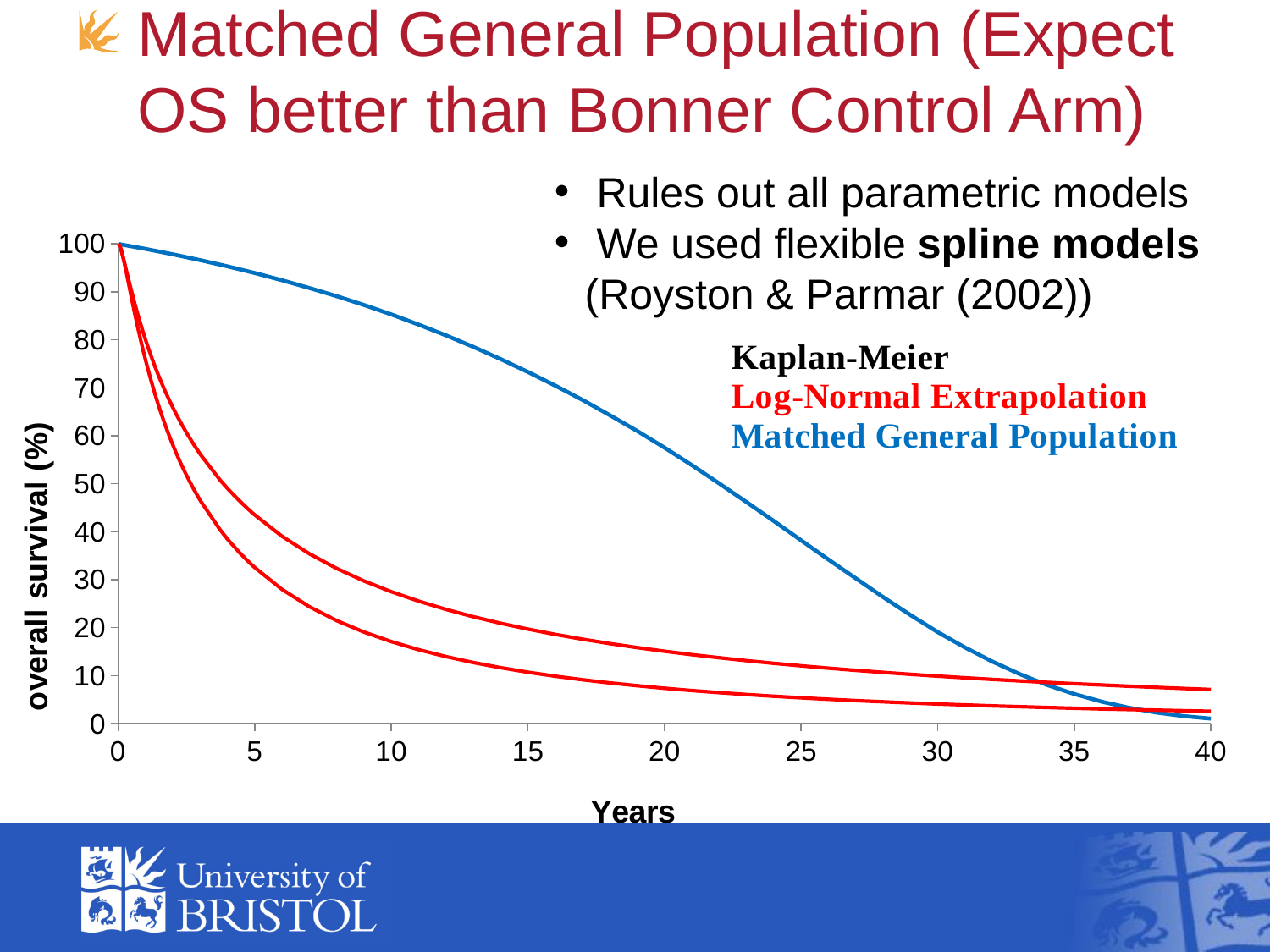
What is the overall survival value of the Matched General Population curve at year 0? 100 Is the value of the upper Log-Normal Extrapolation curve at 20 years greater or less than 20? less At 10 years, which is larger: the Matched General Population curve or the Log-Normal Extrapolation curves? Matched General Population Is the value of the Matched General Population curve at 10 years greater or less than 80? greater At 40 years, which is larger: the Matched General Population curve or the upper Log-Normal Extrapolation curve? upper Log-Normal Extrapolation Do the survival curves rise or fall as years increase along the x axis? fall What is the label of the x axis? Years Is the value of the lower Log-Normal Extrapolation curve at 10 years greater or less than 20? less What is the label of the y axis? overall survival (%) What kind of chart is shown on the slide? line chart How many series does the legend list? 3